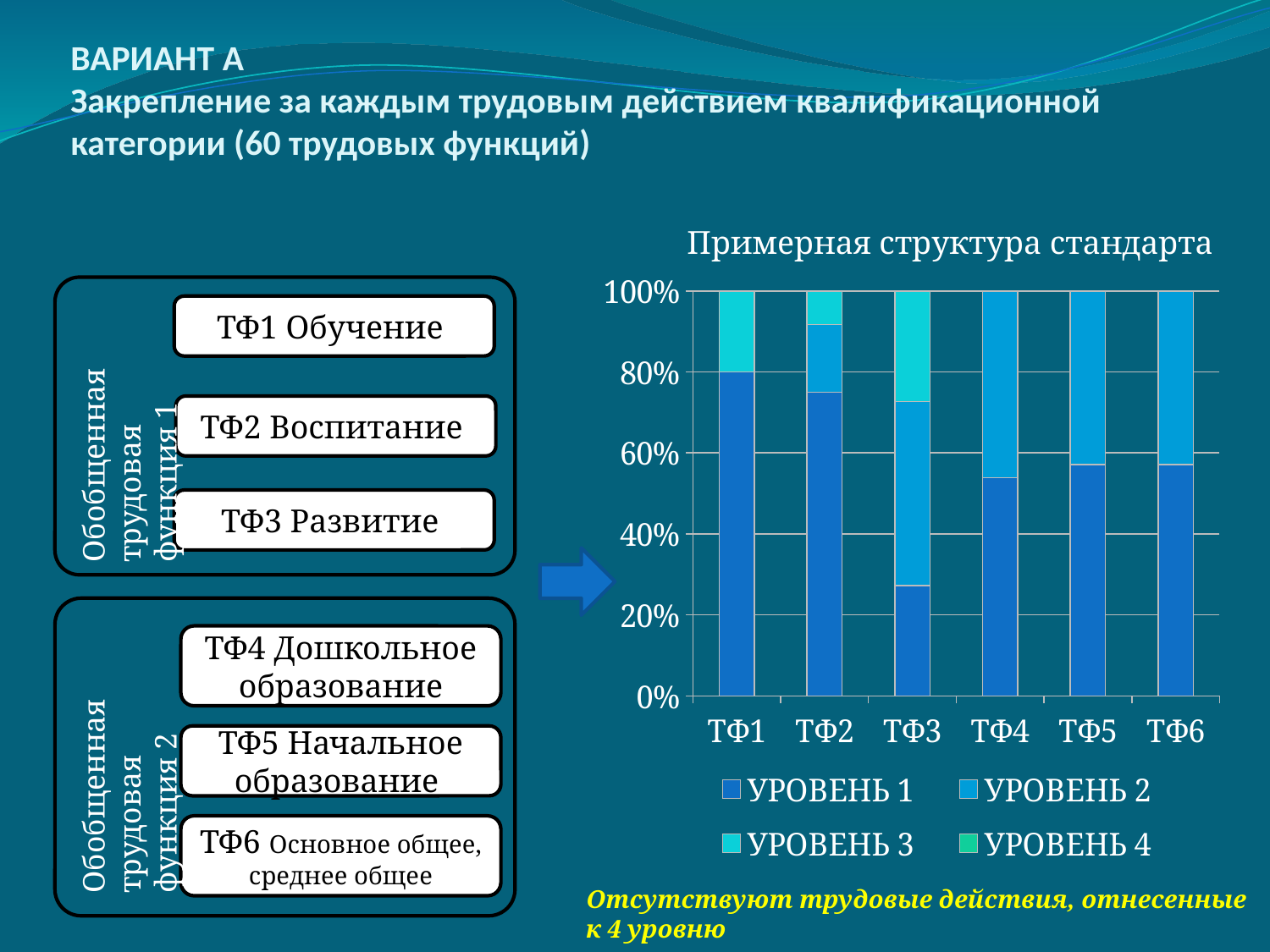
Is the УРОВЕНЬ 1 share for ТФ4 greater or less than 40%? greater Which legend entry is listed last in the chart legend? УРОВЕНЬ 4 What is the title of the chart? Примерная структура стандарта What kind of chart is shown on the slide? Stacked bar chart Which is larger, the УРОВЕНЬ 1 share for ТФ2 or for ТФ4? ТФ2 How many categories are shown on the x axis of the chart? 6 Which is larger, the УРОВЕНЬ 3 share for ТФ1 or for ТФ2? ТФ1 Which category has the smallest share for УРОВЕНЬ 1? ТФ3 How many series does the chart legend list? 4 Is the УРОВЕНЬ 1 share for ТФ2 greater or less than 60%? greater Which category has the largest share for УРОВЕНЬ 1? ТФ1 Is the УРОВЕНЬ 1 share for ТФ3 greater or less than 40%? less